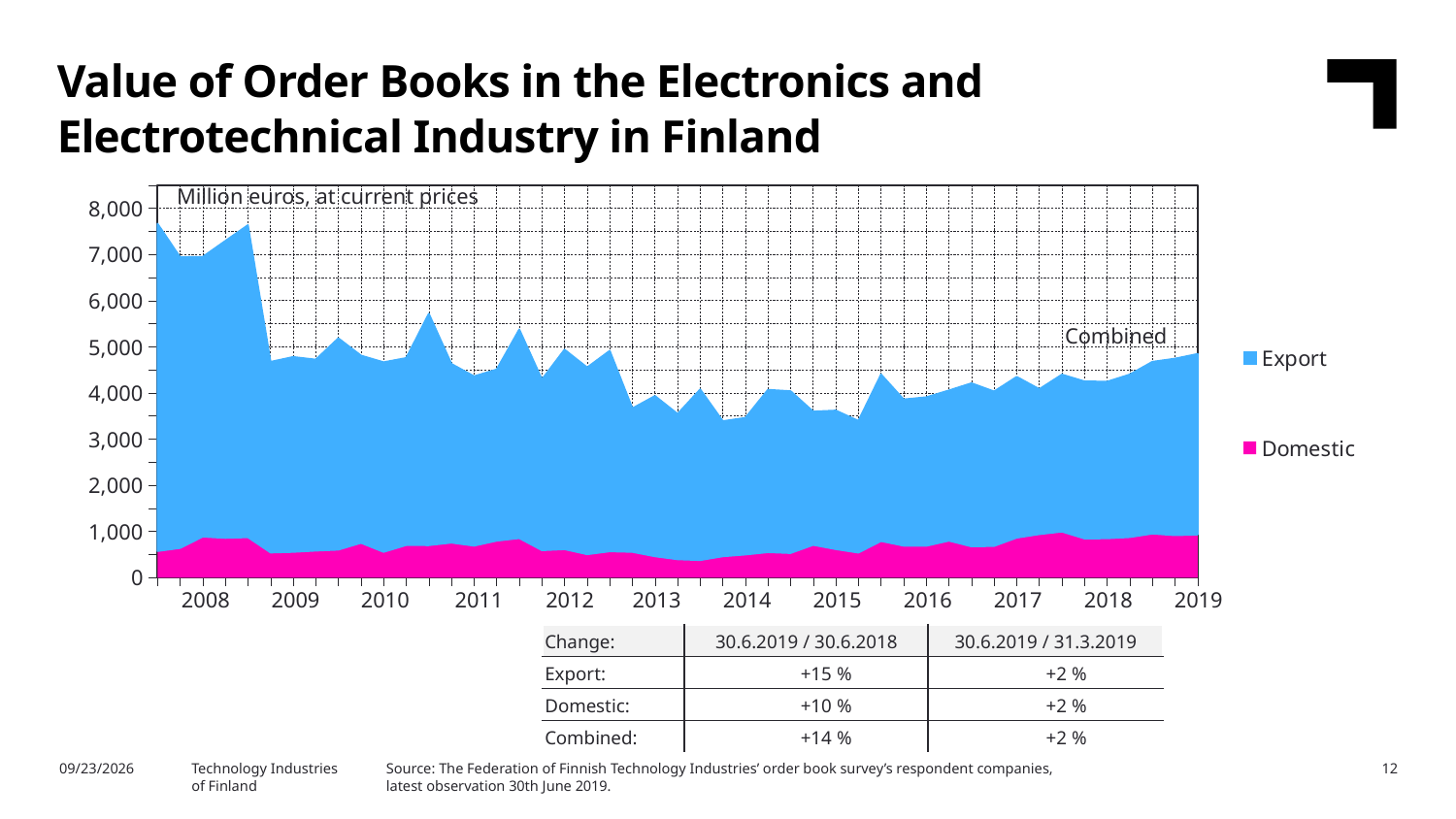
What unit is stated at the top of the chart area? Million euros, at current prices Is the combined value in 2014 greater or less than 5,000? less Is the combined value at 2019 greater or less than 6,000? less Which two series are listed in the chart legend? Export and Domestic In which year does the combined value reach its highest level? 2008 According to the table below the chart, what is the Export change for 30.6.2019 / 30.6.2018? +15 % How many year labels are shown along the x axis? 12 Is the Domestic value in 2014 greater or less than 1,000? less What kind of chart is shown on the slide? Stacked area chart Does the combined value rise or fall from 2008 to 2014? fall How many series does the chart legend list? 2